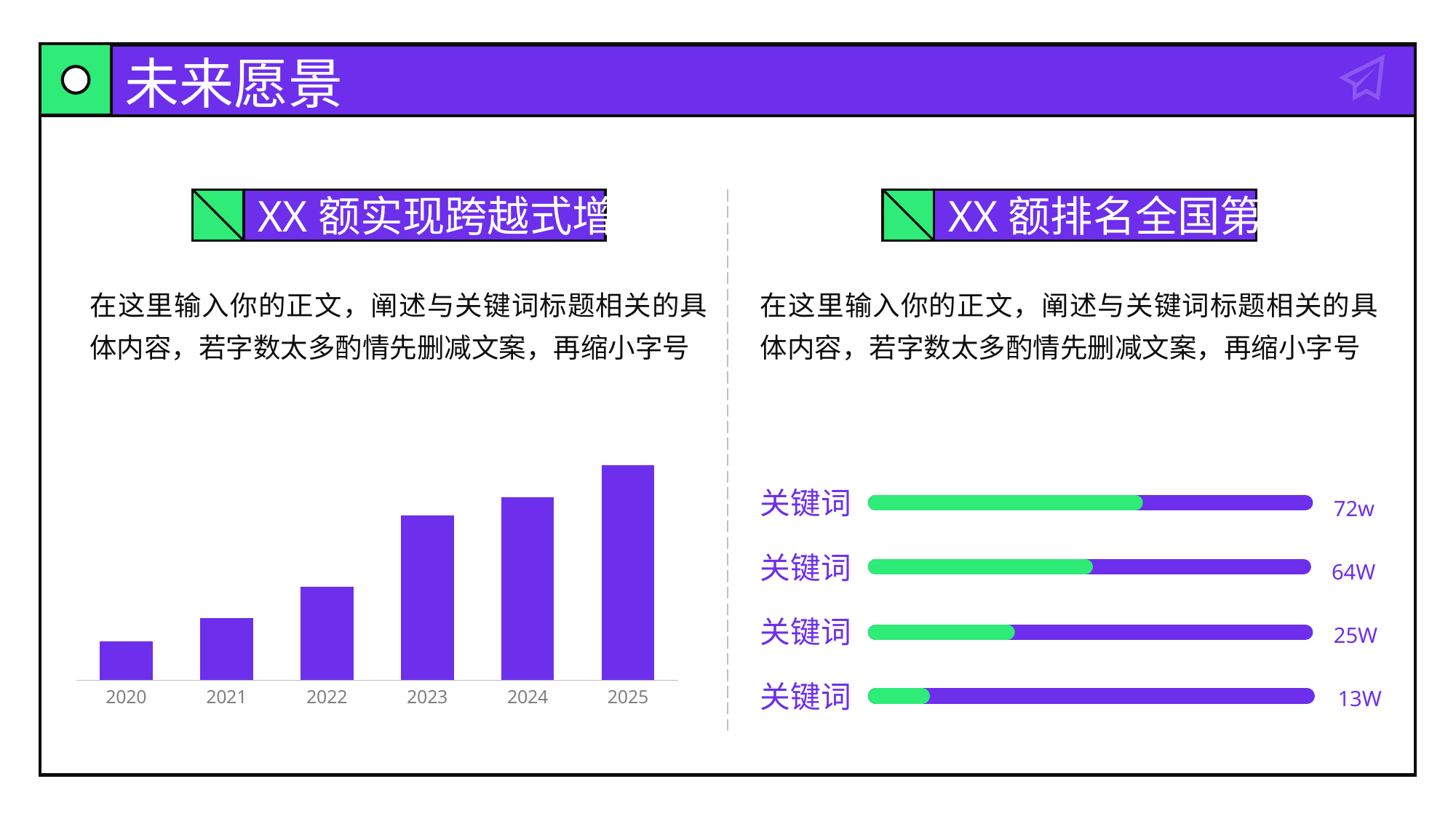
In the left bar chart, what is the first year shown on the x axis? 2020 In the left bar chart, which year has the shortest bar? 2020 In the left bar chart, do the values rise or fall from 2020 to 2025? rise In the right chart, how many horizontal bars are there? 4 In the left bar chart, how many years are shown on the x axis? 6 In the right chart, what value is printed next to the top bar? 72w In the left bar chart, which bar is taller, 2022 or 2023? 2023 In the left bar chart, which year has the tallest bar? 2025 In the right chart, what value is printed next to the bottom bar? 13W In the right chart, what is the smallest value shown? 13W In the right chart, what is the difference between the second bar (64W) and the third bar (25W)? 39W What type of chart is shown on the left side of the slide? bar chart